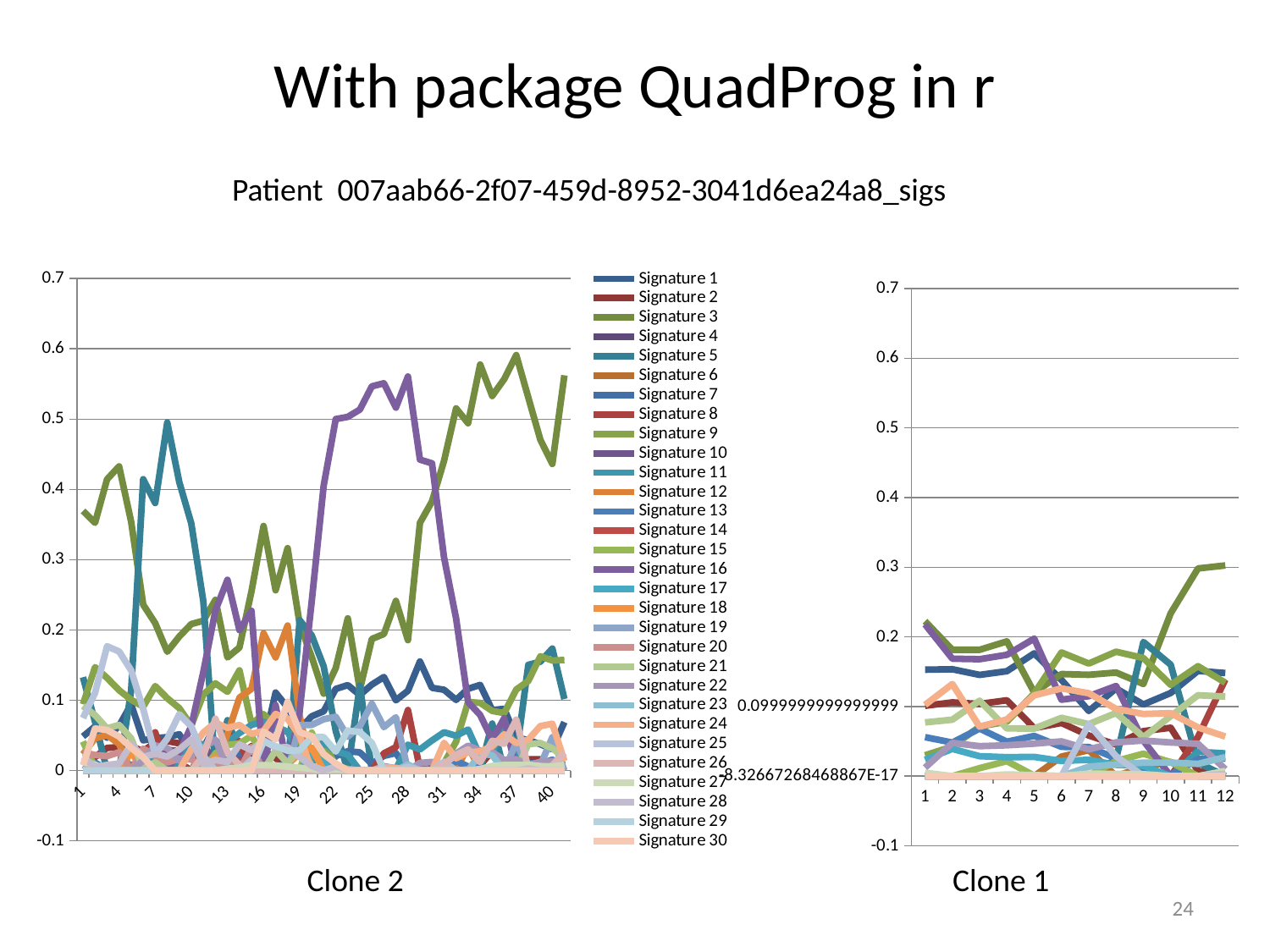
How many points are plotted along the x axis of the Clone 1 chart? 12 How many series does the legend between the two charts list? 30 On the Clone 2 chart, is the highest value reached by any line greater or less than 0.5? greater What kind of chart is the Clone 1 chart on the right? line chart What is the maximum value shown on the y axis of the Clone 2 chart? 0.7 On the Clone 1 chart, is the highest value reached by any line greater or less than 0.4? less On the Clone 1 chart, is the highest value reached by any line greater or less than 0.2? greater Which chart reaches a higher peak value, Clone 2 or Clone 1? Clone 2 What kind of chart is the Clone 2 chart on the left? line chart What is the first entry in the legend? Signature 1 What is the last entry in the legend? Signature 30